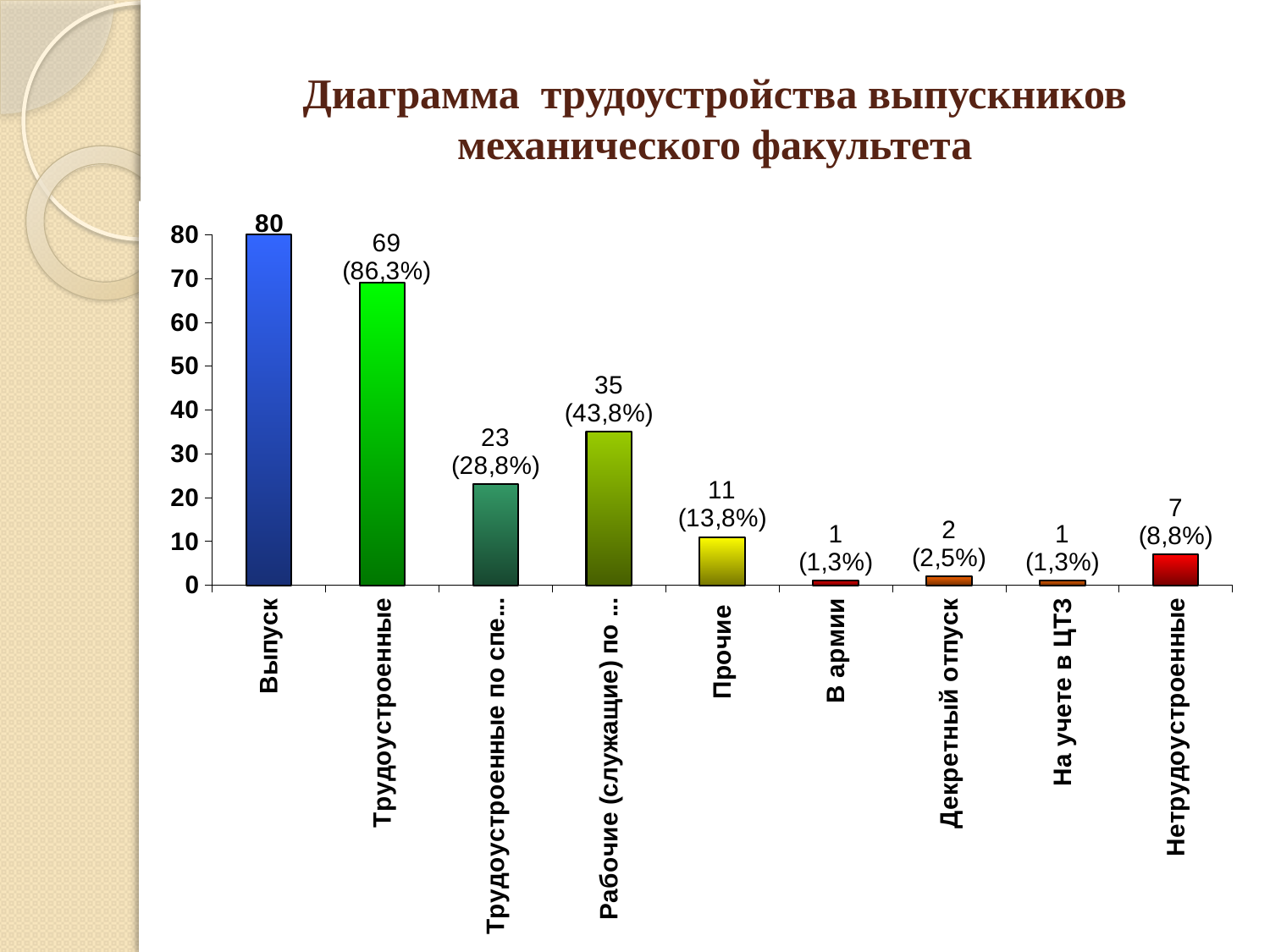
What kind of chart is shown on the slide? bar chart What is the value for Прочие? 11 What is the value for Трудоустроенные? 69 What is the difference between the values for Выпуск and Трудоустроенные? 11 Which is larger, the value for Прочие or the value for Нетрудоустроенные? Прочие Which category has the highest value? Выпуск What is the value for Выпуск? 80 What percentage is shown for Нетрудоустроенные? 8,8% Is the value for Трудоустроенные greater or less than 60? greater How many categories are shown on the x axis? 9 What is the title of the chart? Диаграмма трудоустройства выпускников механического факультета What is the value for Декретный отпуск? 2